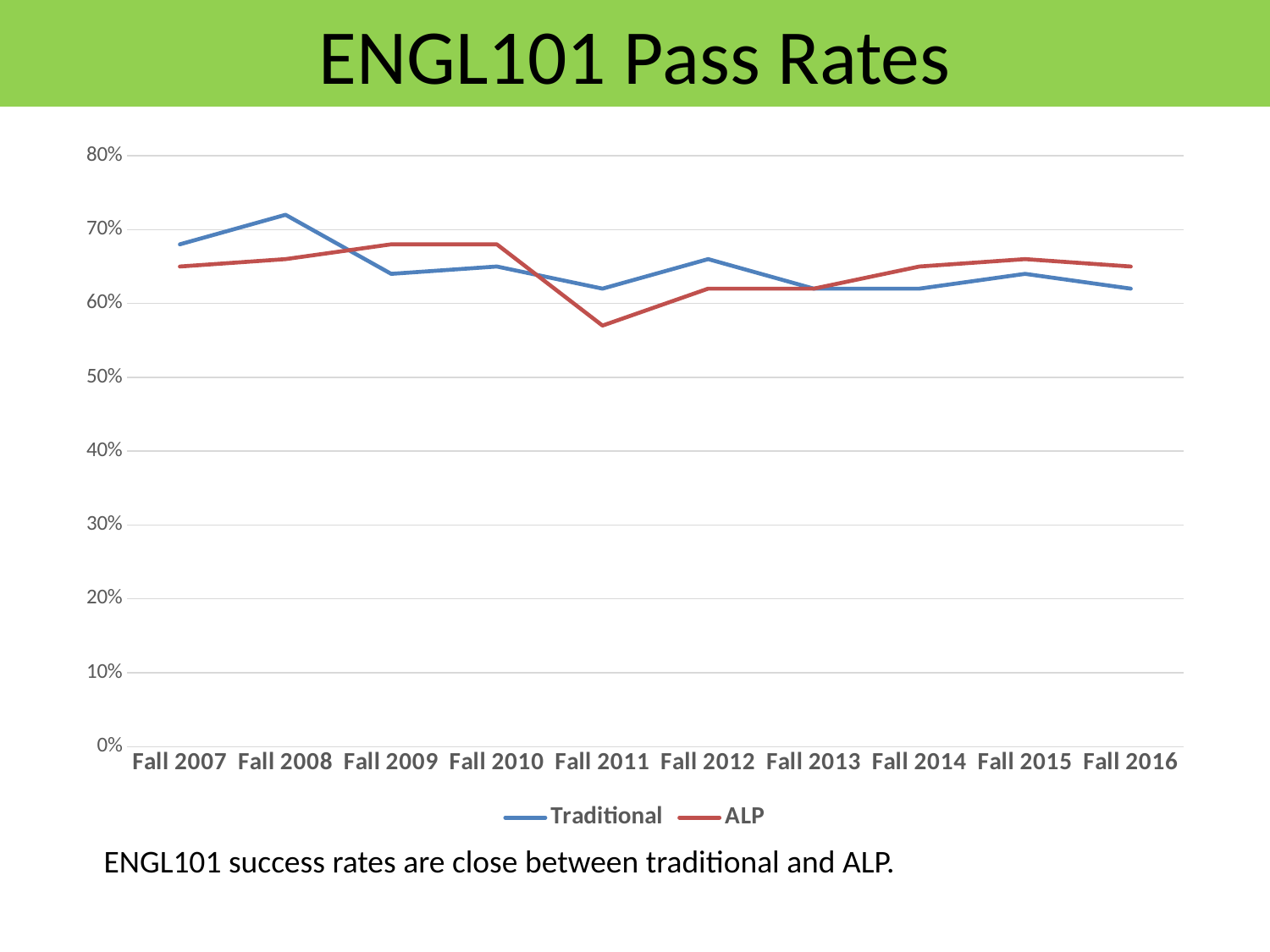
What is the title of the chart? ENGL101 Pass Rates In which semester does the ALP series reach its lowest pass rate? Fall 2011 What kind of chart is shown on the slide? line chart In Fall 2011, which series has the higher pass rate, Traditional or ALP? Traditional How many series does the legend list? 2 Is the Traditional pass rate for Fall 2008 greater or less than 70%? greater Does the ALP pass rate rise or fall from Fall 2010 to Fall 2011? fall In which semester does the Traditional series reach its highest pass rate? Fall 2008 Is the ALP pass rate for Fall 2011 greater or less than 60%? less Is the Traditional pass rate for Fall 2007 greater or less than 70%? less In Fall 2010, which series has the higher pass rate, Traditional or ALP? ALP How many semesters are plotted along the x axis? 10